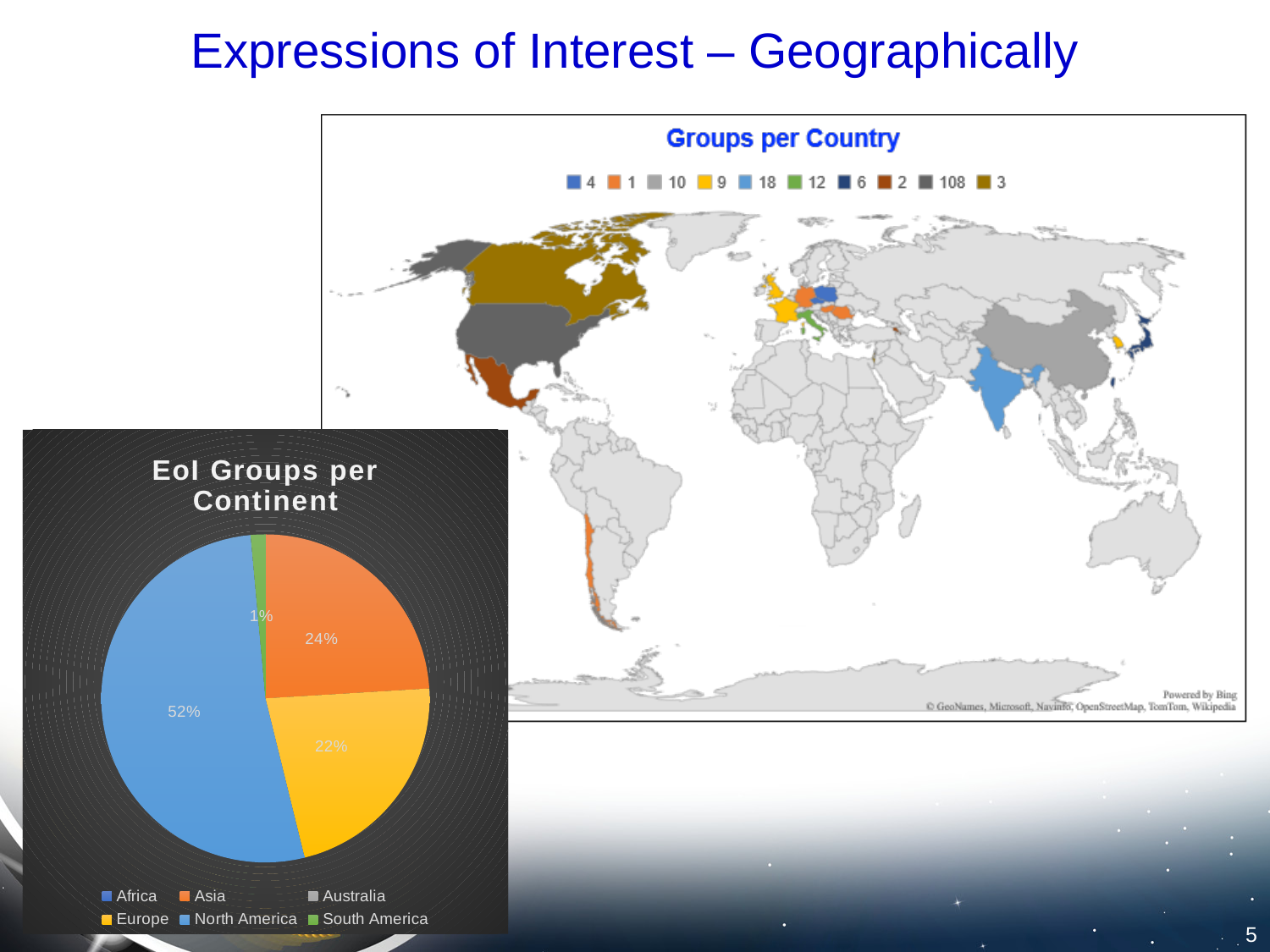
What is the title of the chart on the right of the slide? Groups per Country In the EoI Groups per Continent pie chart, what percentage is shown for Asia? 24% What kind of chart is the Groups per Country chart on the right of the slide? Map chart How many continents are listed in the legend of the EoI Groups per Continent chart? 6 In the EoI Groups per Continent pie chart, which has the larger share, Asia or Europe? Asia What kind of chart is the EoI Groups per Continent chart? Pie chart In the EoI Groups per Continent pie chart, what percentage is shown for Europe? 22% In the EoI Groups per Continent pie chart, what is the difference between the shares of Asia and Europe? 2% In the EoI Groups per Continent pie chart, what share does South America have? 1% How many entries are listed in the legend of the Groups per Country map chart? 10 In the EoI Groups per Continent pie chart, what share does North America have? 52% In the EoI Groups per Continent pie chart, which continent has the largest slice? North America